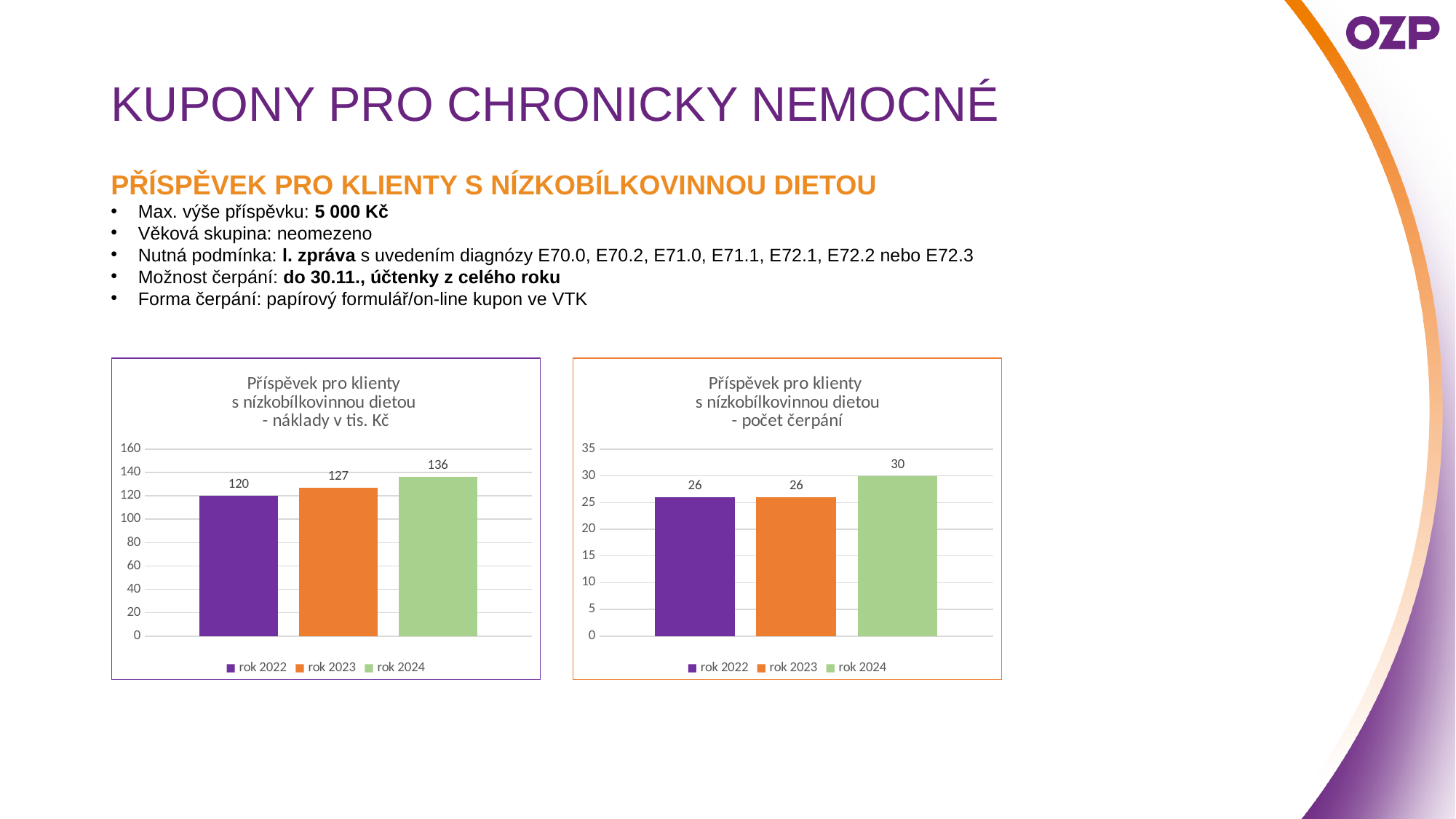
In the right chart (počet čerpání), which is larger, rok 2024 or rok 2023? rok 2024 In the left chart (náklady v tis. Kč), what is the difference between rok 2024 and rok 2022? 16 In the left chart (náklady v tis. Kč), do the values rise or fall from rok 2022 to rok 2024? rise In the right chart (počet čerpání), what is the value for rok 2023? 26 In the right chart (počet čerpání), what is the difference between rok 2024 and rok 2022? 4 What kind of chart is the left chart (náklady v tis. Kč)? bar chart In the left chart (náklady v tis. Kč), which year has the highest value? rok 2024 In the left chart (náklady v tis. Kč), what is the value for rok 2024? 136 In the left chart (náklady v tis. Kč), which year has the lowest value? rok 2022 In the right chart (počet čerpání), what is the value for rok 2024? 30 In the left chart (náklady v tis. Kč), what is the value for rok 2022? 120 How many series does the legend of the right chart (počet čerpání) list? 3